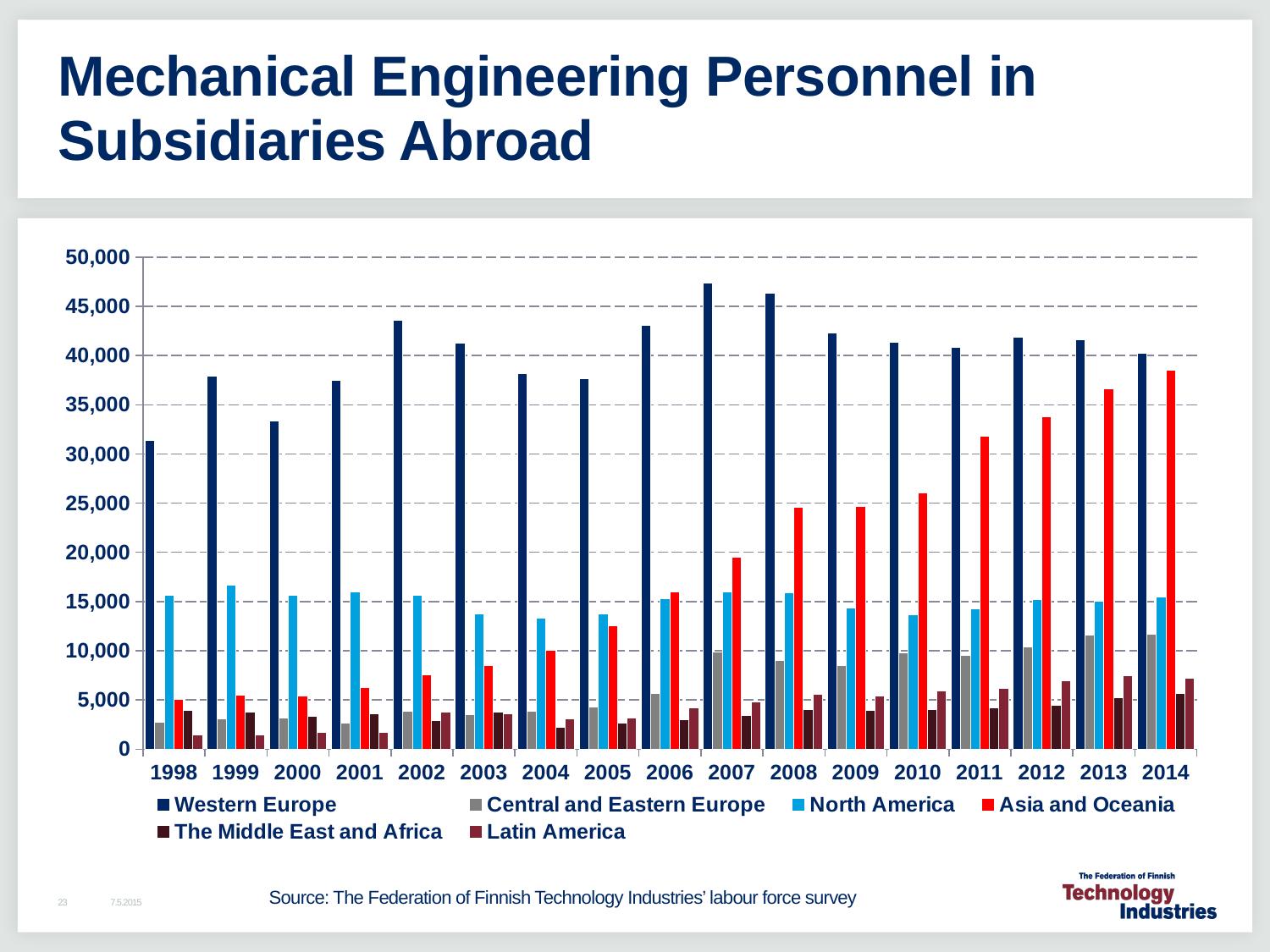
How many years are shown on the x axis? 17 In which year is the Western Europe value highest? 2007 How many series does the legend list? 6 In which year is the Western Europe value lowest? 1998 In which year is the Asia and Oceania value highest? 2014 Is the value for Asia and Oceania in 2014 greater or less than 35,000? greater Is the value for Western Europe in 2007 greater or less than 45,000? greater In 2008, which is larger: Asia and Oceania or North America? Asia and Oceania Is the value for Asia and Oceania in 1998 greater or less than 10,000? less What is the title of the chart? Mechanical Engineering Personnel in Subsidiaries Abroad What kind of chart is shown on the slide? bar chart Does the Asia and Oceania series rise or fall from 1998 to 2014? rise